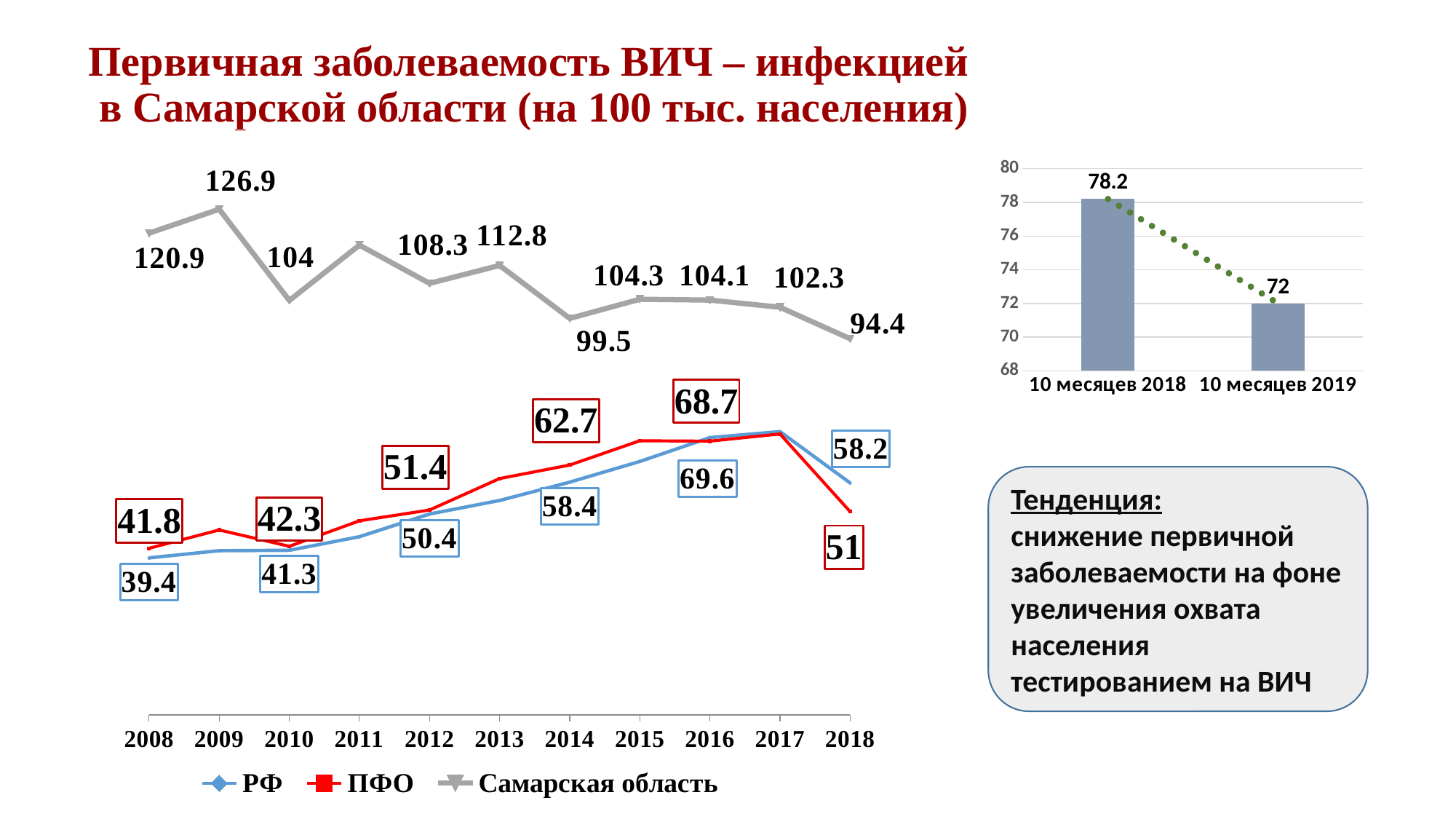
On the line chart on the left, what is the value for Самарская область in 2018? 94.4 On the bar chart on the right, what is the value for 10 месяцев 2019? 72 On the bar chart on the right, what is the value for 10 месяцев 2018? 78.2 What kind of chart is the small chart on the right of the slide? bar chart On the line chart on the left, how many series does the legend list? 3 On the line chart on the left, what is the value for РФ in 2008? 39.4 On the line chart on the left, what is the value for Самарская область in 2009? 126.9 On the bar chart on the right, what is the difference between the values for 10 месяцев 2018 and 10 месяцев 2019? 6.2 On the line chart on the left, in which year is the value for Самарская область highest? 2009 On the line chart on the left, how many years are shown on the x axis? 11 On the line chart on the left, what is the value for ПФО in 2018? 51 On the line chart on the left, which series has the larger value in 2018, РФ or ПФО? РФ